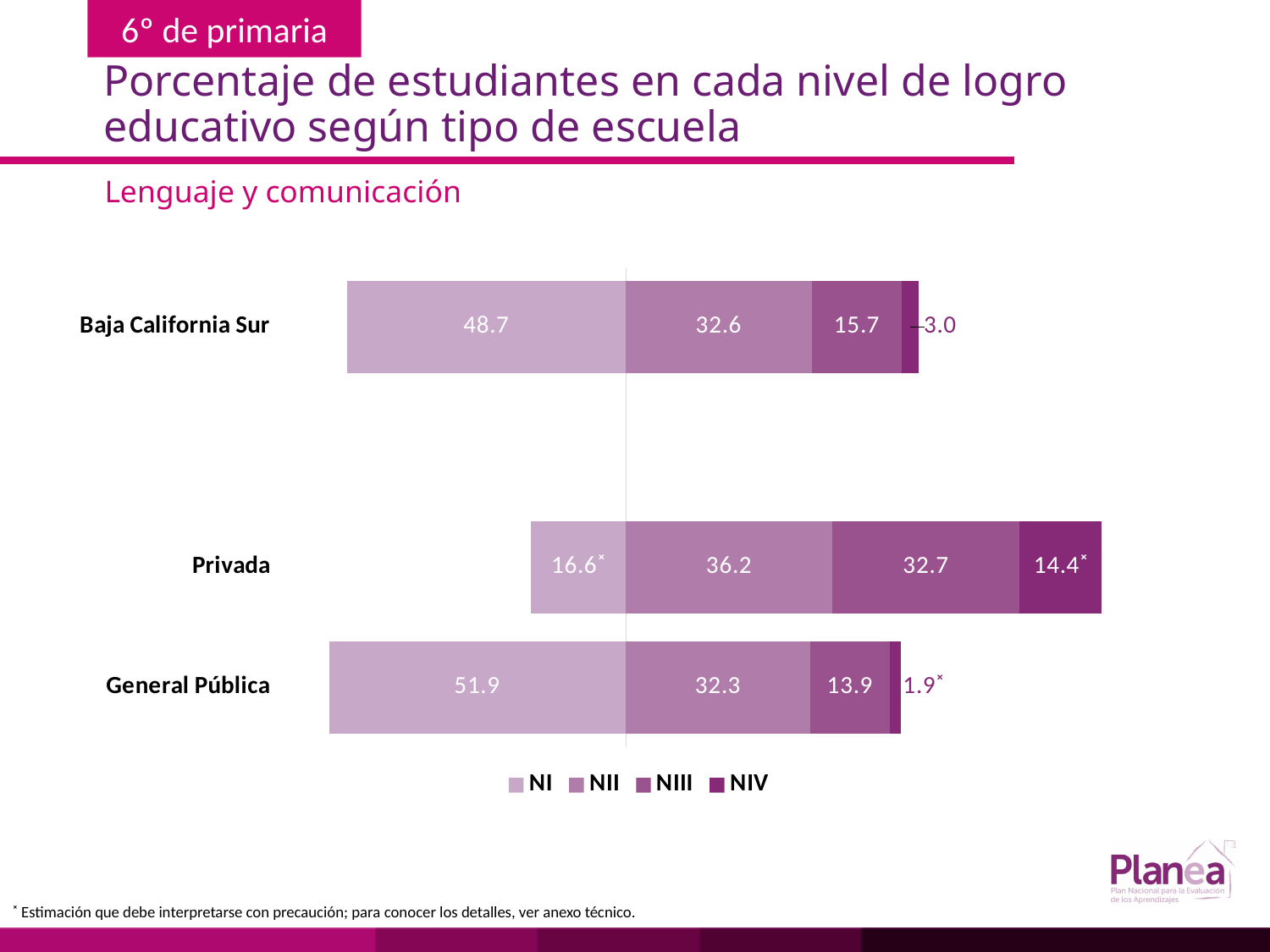
What is the NIII value for Privada? 32.7 Which category has the highest NI value? General Pública Which is larger, the NIII value for Baja California Sur or the NIII value for General Pública? Baja California Sur Which category has the lowest NIV value? General Pública What is the NIV value for General Pública? 1.9 What type of chart is shown on the slide? Stacked bar chart What is the NII value for Privada? 36.2 What is the difference between the NI values for General Pública and Privada? 35.3 What is the NI value for Baja California Sur? 48.7 What is the total of the stacked bar for Privada? 99.9 How many series does the legend list? 4 How many categories are shown on the chart? 3